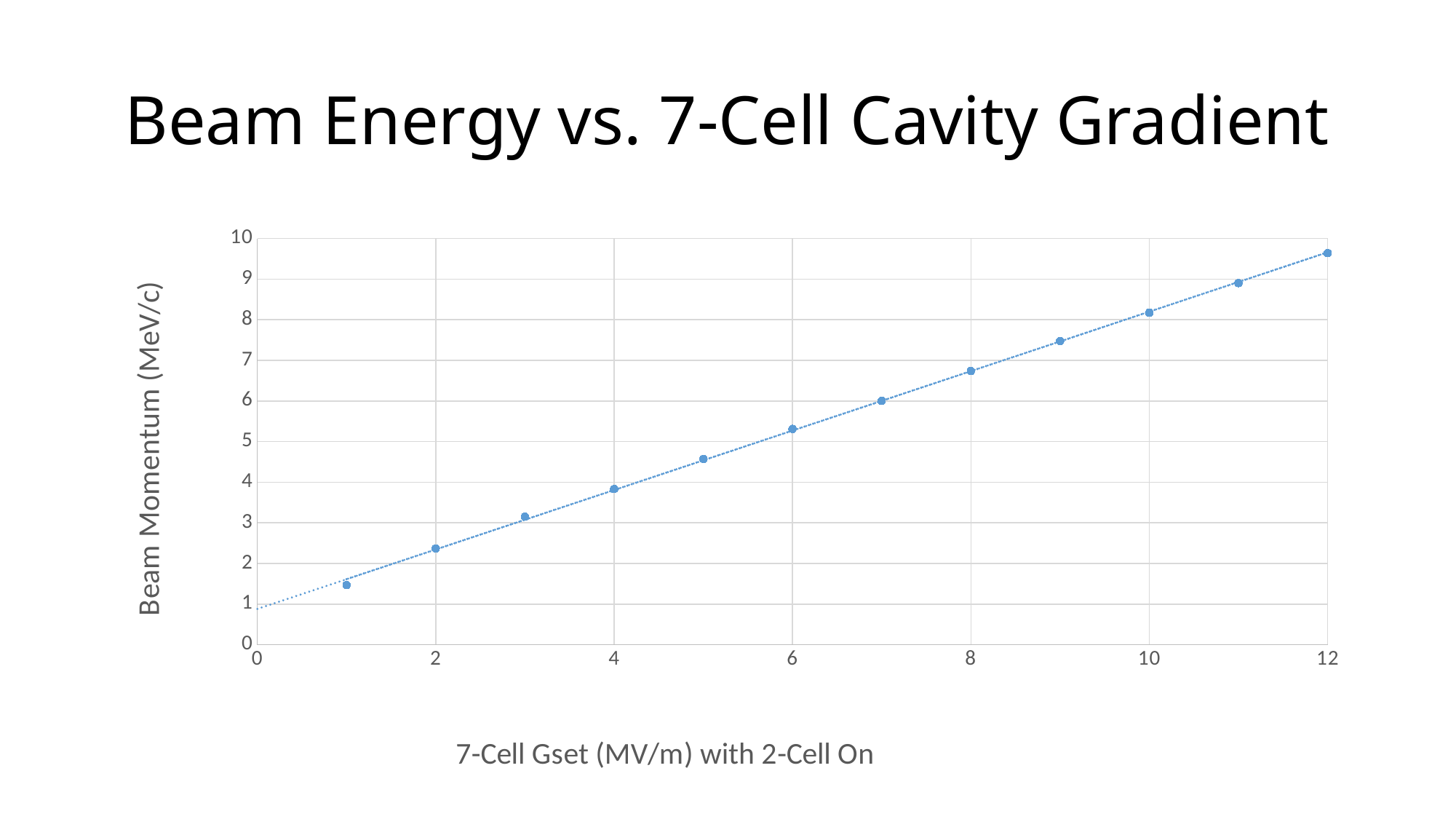
At which 7-Cell Gset value is the beam momentum lowest? 1 How many data points are plotted on the chart? 12 What kind of chart is shown on the slide? scatter chart Which has the larger beam momentum: a 7-Cell Gset of 3 or a 7-Cell Gset of 10? 10 Is the beam momentum at a 7-Cell Gset of 12 greater or less than 9? greater Is the beam momentum at a 7-Cell Gset of 9 greater or less than 7? greater Is the beam momentum at a 7-Cell Gset of 4 greater or less than 4? less What is the title of the chart? Beam Energy vs. 7-Cell Cavity Gradient Do the beam momentum values rise or fall as the 7-Cell Gset increases along the x axis? rise What is the label of the y axis? Beam Momentum (MeV/c) At which 7-Cell Gset value is the beam momentum highest? 12